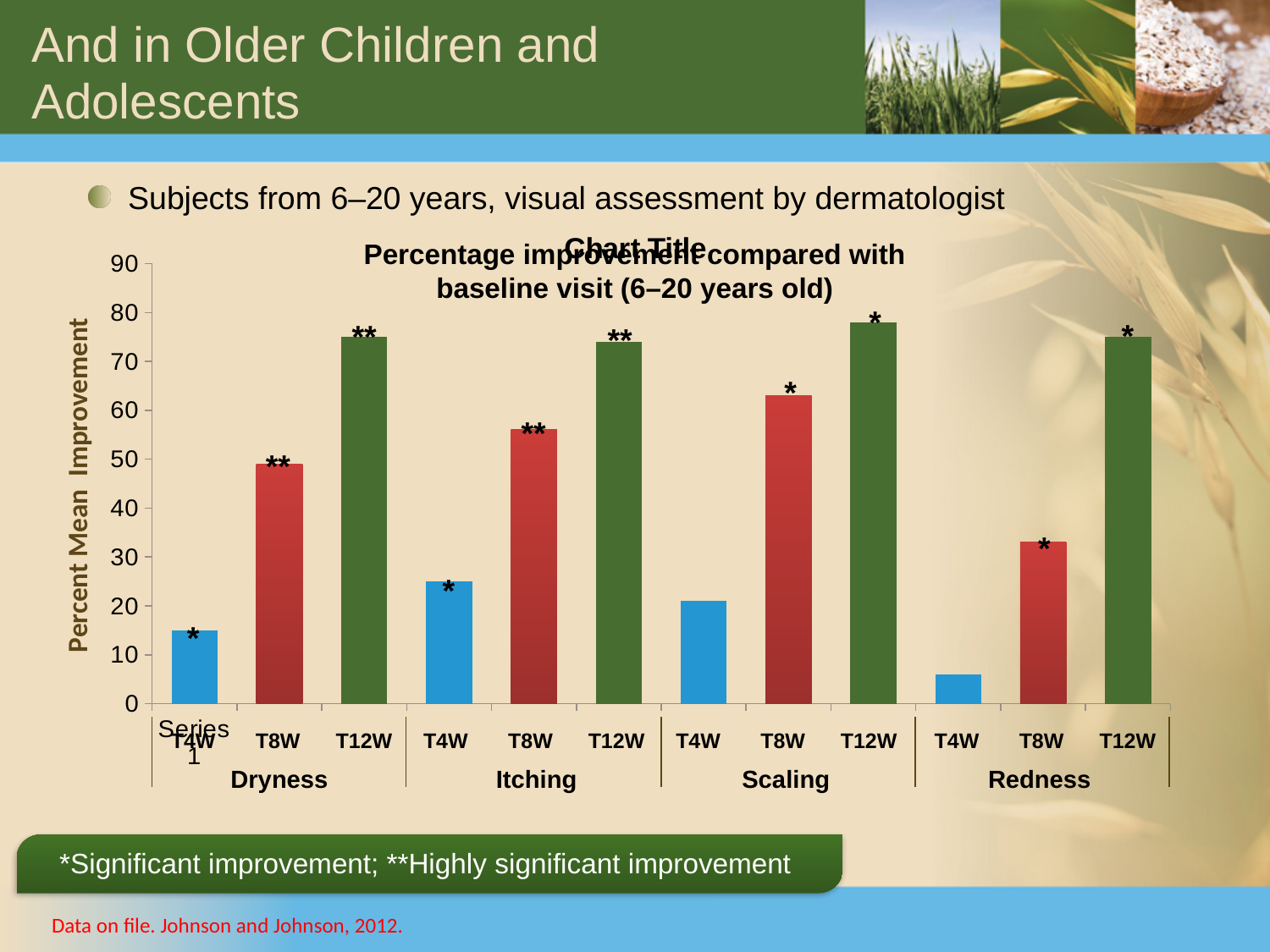
Within each symptom category, do the values rise or fall from T4W to T12W? rise Is the value for Dryness T8W greater or less than 40? greater Is the value for Redness T8W greater or less than 40? less How many symptom categories are shown along the x axis of the chart? 4 Is the value for Itching T4W greater or less than 30? less How many bars are plotted in the chart in total? 12 Which bar in the chart has the lowest value? Redness T4W What is the label on the vertical axis of the chart? Percent Mean Improvement What kind of chart is shown on the slide? Bar chart Which is larger, the value for Scaling T4W or the value for Redness T4W? Scaling T4W